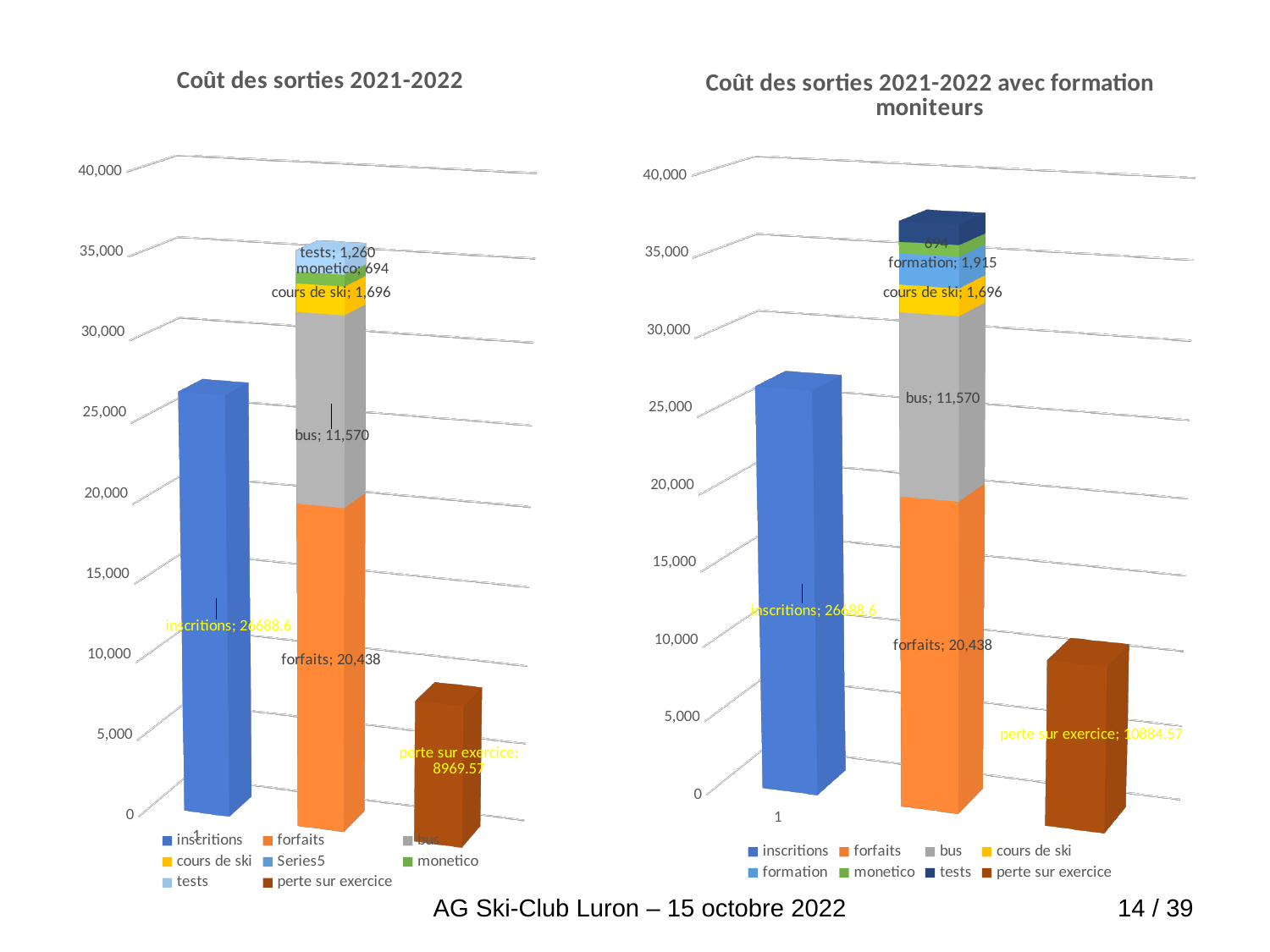
In the right chart (avec formation moniteurs), which is larger, forfaits or bus? forfaits In the right chart (avec formation moniteurs), what is the value for formation? 1,915 How many series does the legend of the right chart (avec formation moniteurs) list? 8 What kind of chart is the left chart (Coût des sorties 2021-2022)? bar chart In the right chart (avec formation moniteurs), what is the value for perte sur exercice? 10884.57 In the left chart (Coût des sorties 2021-2022), which series has the largest value? inscritions In the right chart (avec formation moniteurs), is the value for perte sur exercice greater or less than 10,000? greater In the left chart (Coût des sorties 2021-2022), what is the value for perte sur exercice? 8969.57 In the left chart (Coût des sorties 2021-2022), what is the value for tests? 1,260 In the left chart (Coût des sorties 2021-2022), what is the value for cours de ski? 1,696 In the left chart (Coût des sorties 2021-2022), what is the difference between forfaits and bus? 8,868 In the left chart (Coût des sorties 2021-2022), what is the value for bus? 11,570